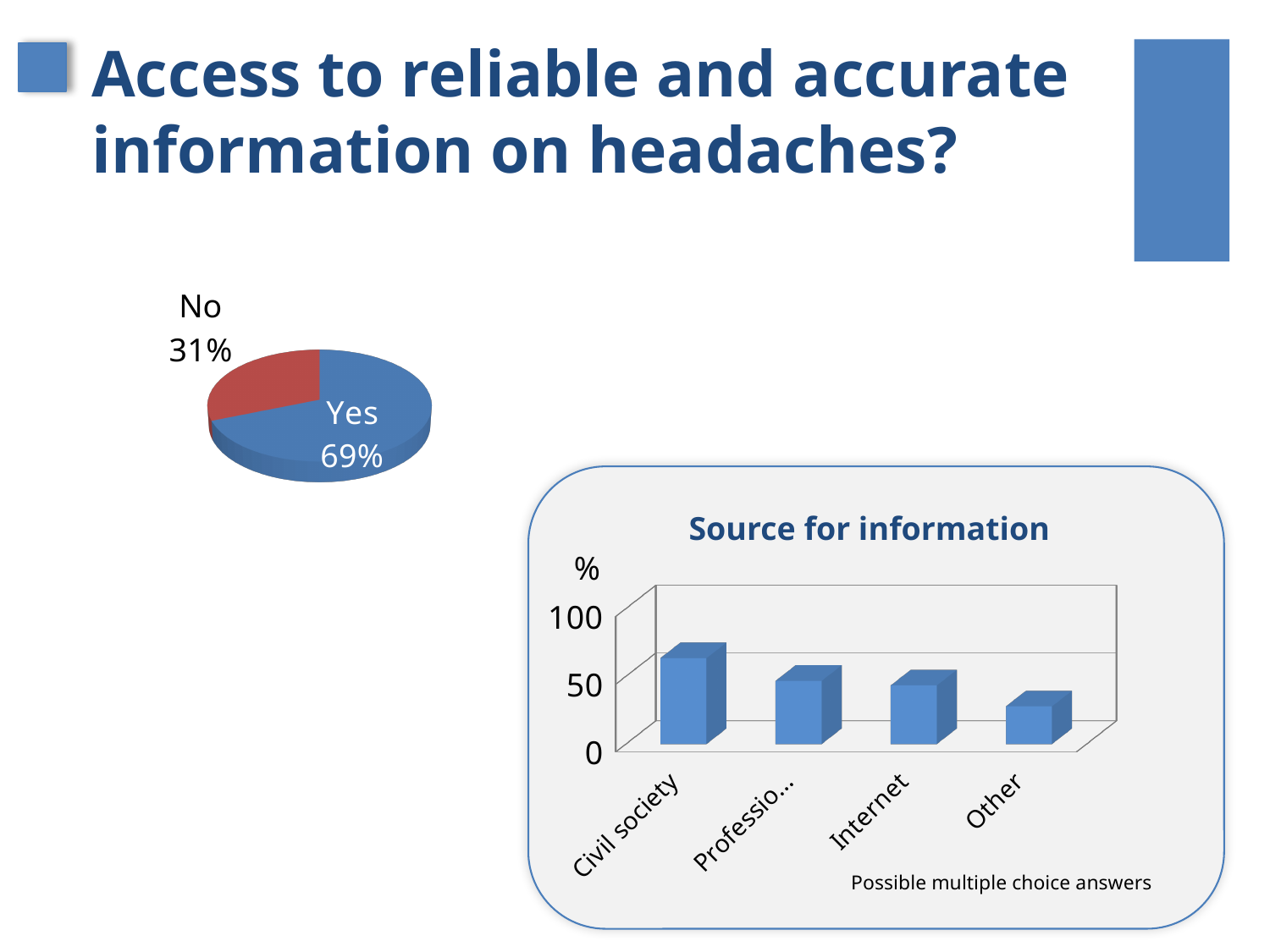
What kind of chart is the chart on the left of the slide? Pie chart On the pie chart, how many slices are there? 2 On the pie chart, what percentage of respondents answered Yes? 69% On the pie chart, what is the difference in percentage points between the Yes and No shares? 38 percentage points On the 'Source for information' chart, which category has the lowest value? Other On the 'Source for information' chart, is the value for Civil society greater or less than 50? greater On the 'Source for information' chart, is the value for Other greater or less than 50? less On the 'Source for information' chart, how many categories are shown on the x axis? 4 On the pie chart, which answer has the larger share, Yes or No? Yes On the 'Source for information' chart, which category has the highest value? Civil society On the pie chart, what percentage of respondents answered No? 31% What kind of chart is the 'Source for information' chart? Bar chart